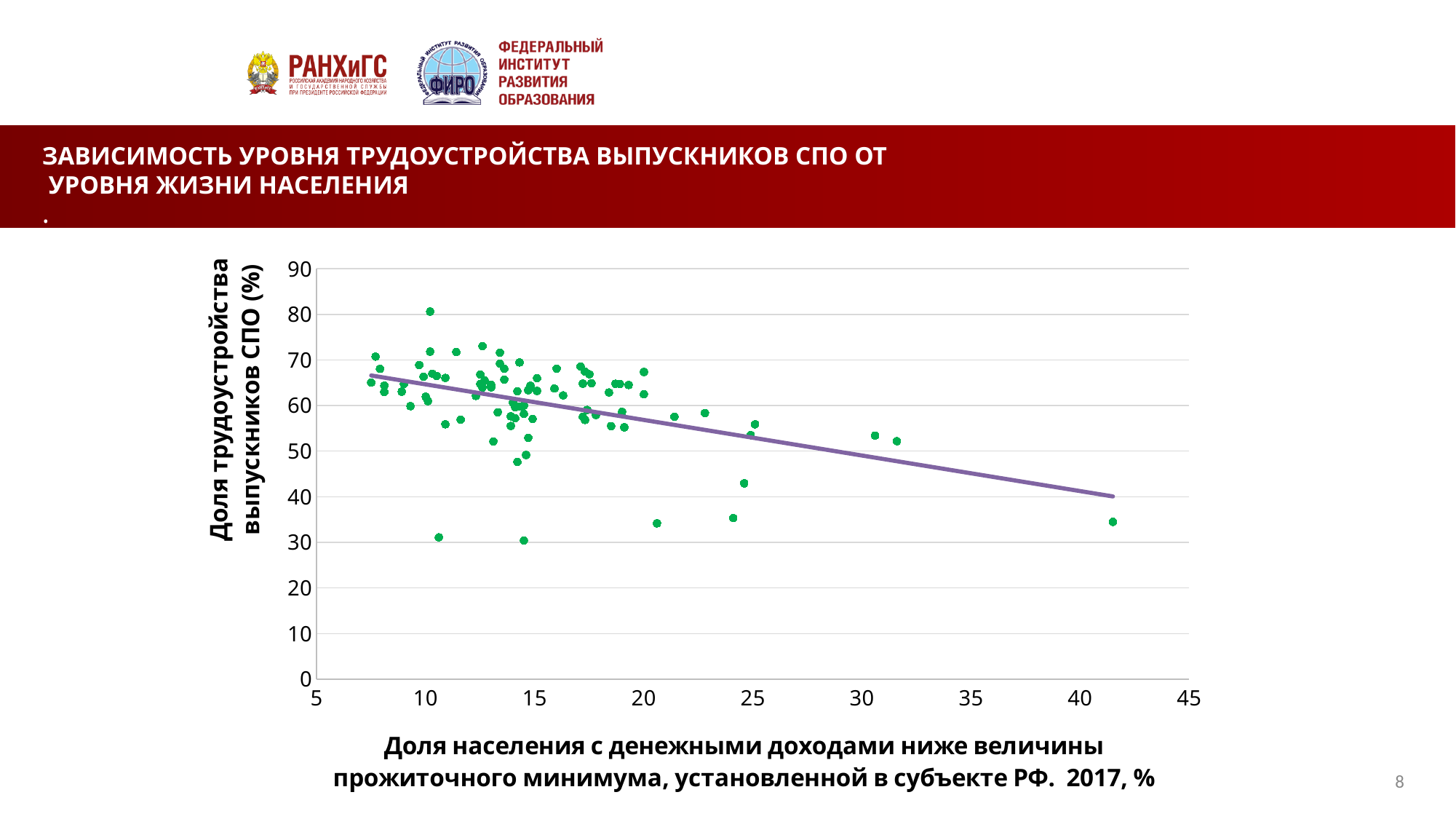
Is the value of the trend line at its left end (around 7–8 on the x axis) greater or less than 60? greater Are the two points plotted near 30–32 on the x axis greater or less than 60 on the y axis? less Is the value of the trend line at its right end (around 41 on the x axis) greater or less than 50? less What is the highest value shown on the y axis of the chart? 90 What kind of chart is shown on the slide? scatter chart What is the label of the y axis of the chart? Доля трудоустройства выпускников СПО (%) As the share of population with incomes below the subsistence minimum increases along the x axis, does the employment share of SPO graduates generally rise or fall according to the trend line? fall